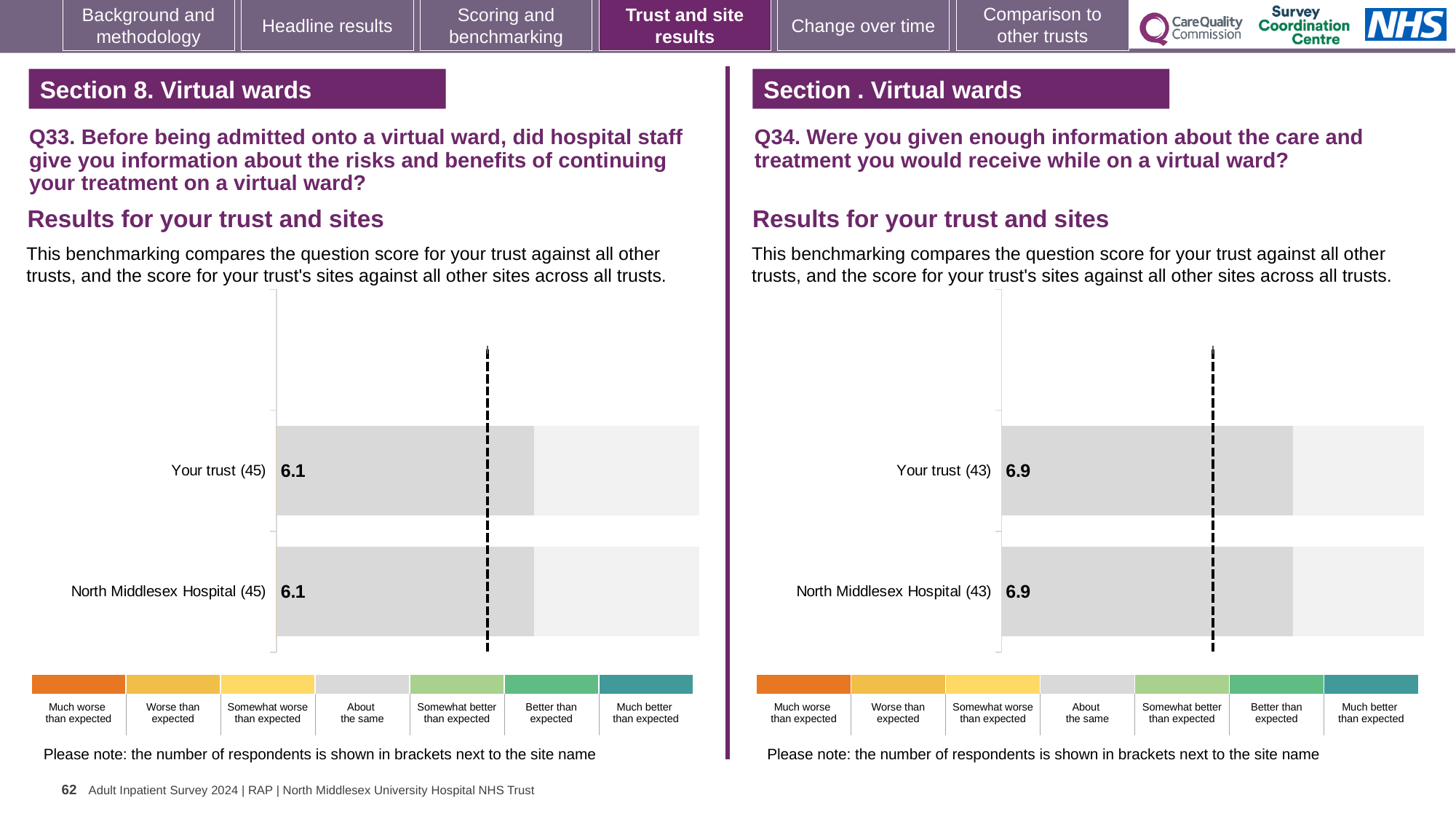
How many categories does the colour scale below the right chart (Q34) list? 7 On the left chart (Q33), what is the score for Your trust? 6.1 What kind of chart is used on the right (Q34)? Bar chart On the left chart (Q33), which category does the colour scale below the chart label with the darkest orange colour? Much worse than expected On the left chart (Q33), what is the difference between the score for Your trust and the score for North Middlesex Hospital? 0 On the right chart (Q34), what is the score for Your trust? 6.9 What is the difference between the Your trust score on the right chart (Q34) and the Your trust score on the left chart (Q33)? 0.8 On the left chart (Q33), how many respondents are shown in brackets for Your trust? 45 On the left chart (Q33), what is the score for North Middlesex Hospital? 6.1 On the right chart (Q34), what is the score for North Middlesex Hospital? 6.9 On the right chart (Q34), how many respondents are shown in brackets for North Middlesex Hospital? 43 How many bars are plotted on the left chart (Q33)? 2